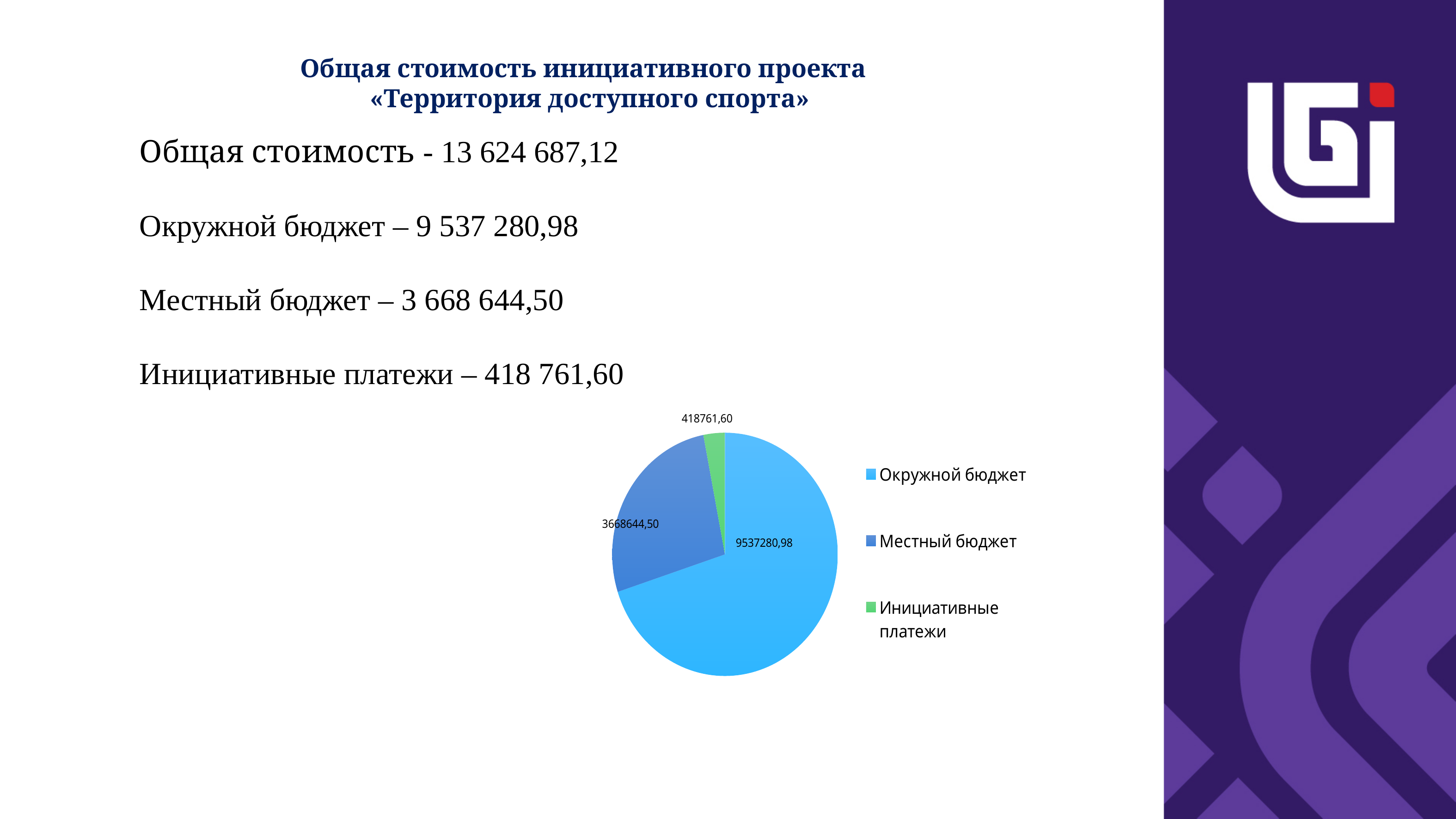
What is the value shown for Местный бюджет in the pie chart? 3668644,50 What is the value shown for Инициативные платежи in the pie chart? 418761,60 What kind of chart is shown on the slide? Pie chart Which category has the largest slice in the pie chart? Окружной бюджет Which is larger in the pie chart: Местный бюджет or Инициативные платежи? Местный бюджет How many entries does the legend of the pie chart list? 3 What colour is the slice for Инициативные платежи in the pie chart? Green What is the value shown for Окружной бюджет in the pie chart? 9537280,98 What is the difference between the values for Местный бюджет and Инициативные платежи in the pie chart? 3249882,90 How many slices does the pie chart have? 3 What is the difference between the values for Окружной бюджет and Местный бюджет in the pie chart? 5868636,48 Which category has the smallest slice in the pie chart? Инициативные платежи